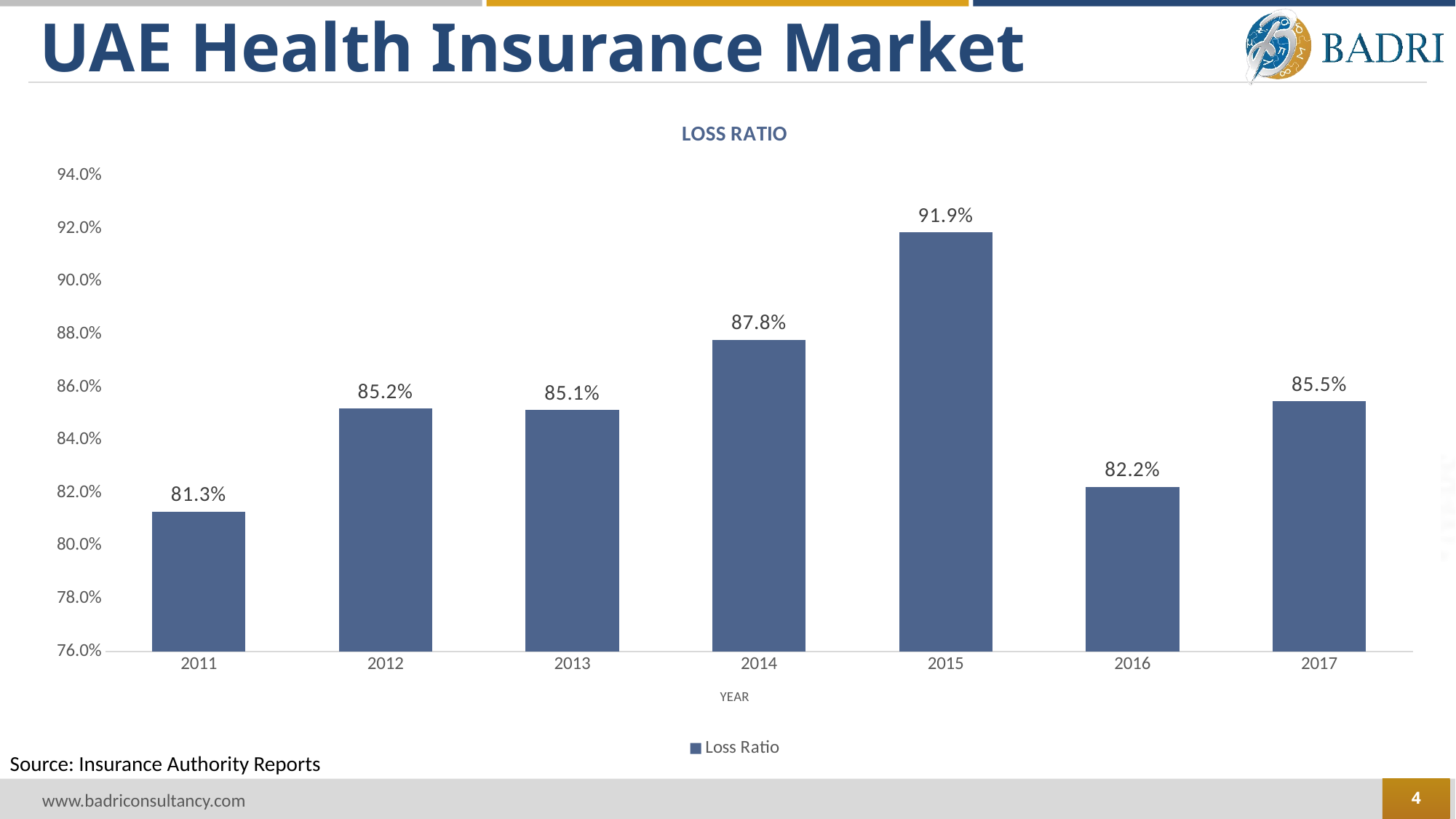
How many years are shown on the chart? 7 Is the loss ratio for 2016 greater or less than 84.0%? less What kind of chart is shown on the slide? bar chart What is the title of the chart? LOSS RATIO What is the loss ratio for 2011? 81.3% What is the loss ratio for 2017? 85.5% What is the difference between the loss ratio in 2015 and in 2016? 9.7% Which year has the lowest loss ratio? 2011 Which year has the highest loss ratio? 2015 Which year has a higher loss ratio, 2014 or 2017? 2014 What is the difference between the loss ratio in 2014 and in 2011? 6.5% What is the loss ratio for 2015? 91.9%